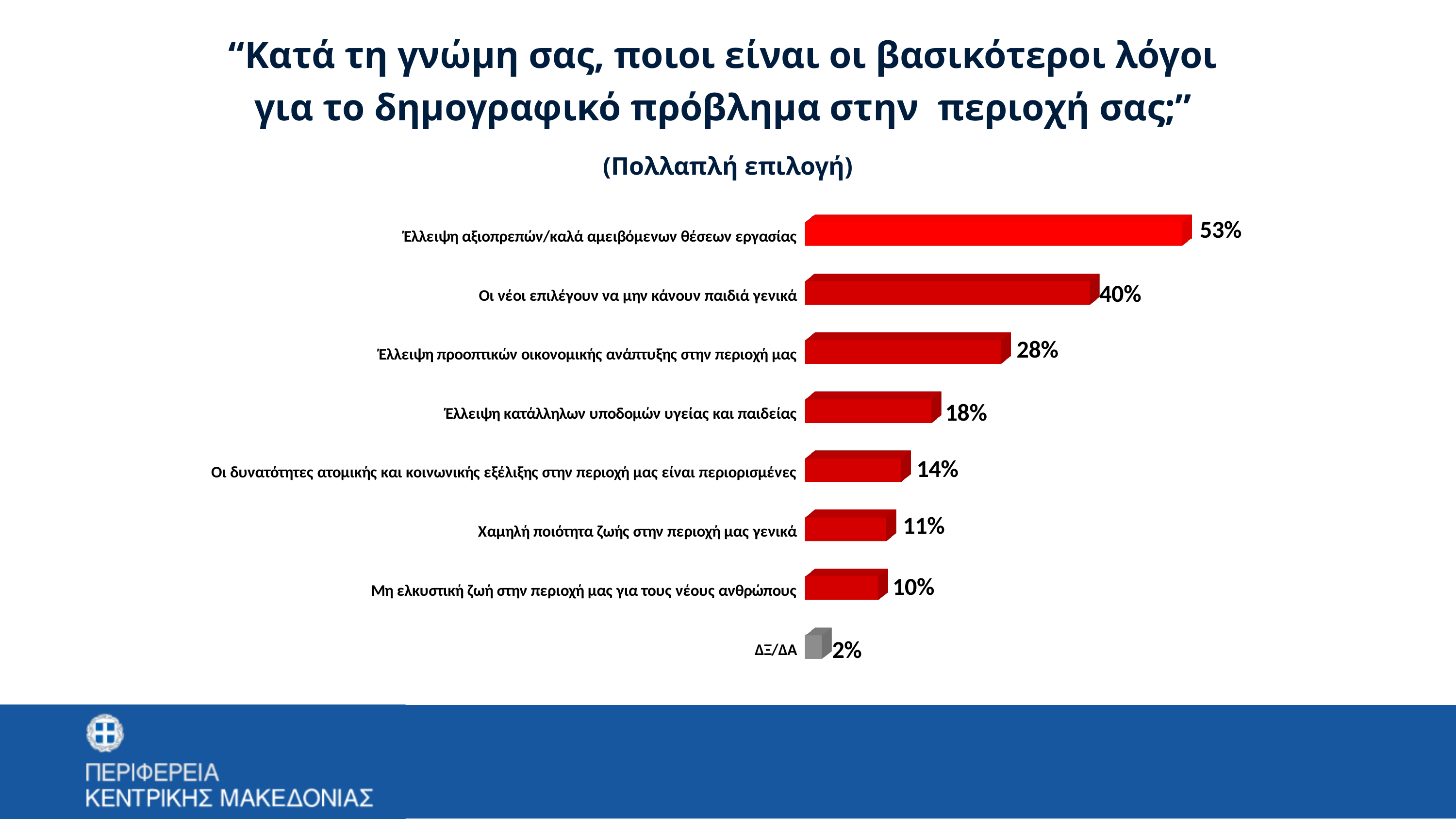
What is the value for "Έλλειψη αξιοπρεπών/καλά αμειβόμενων θέσεων εργασίας"? 53% What is the value for "Οι νέοι επιλέγουν να μην κάνουν παιδιά γενικά"? 40% What is the difference between "Έλλειψη προοπτικών οικονομικής ανάπτυξης στην περιοχή μας" and "Έλλειψη κατάλληλων υποδομών υγείας και παιδείας"? 10% What is the value for "ΔΞ/ΔΑ"? 2% How many categories are shown in the chart? 8 What kind of chart is shown on the slide? Bar chart What is the difference between "Έλλειψη αξιοπρεπών/καλά αμειβόμενων θέσεων εργασίας" and "Οι νέοι επιλέγουν να μην κάνουν παιδιά γενικά"? 13% What is the value for "Έλλειψη κατάλληλων υποδομών υγείας και παιδείας"? 18% Which category has the lowest value? ΔΞ/ΔΑ Which category has the highest value? Έλλειψη αξιοπρεπών/καλά αμειβόμενων θέσεων εργασίας What colour is the bar for "ΔΞ/ΔΑ"? Grey Which is larger: "Χαμηλή ποιότητα ζωής στην περιοχή μας γενικά" or "Μη ελκυστική ζωή στην περιοχή μας για τους νέους ανθρώπους"? Χαμηλή ποιότητα ζωής στην περιοχή μας γενικά